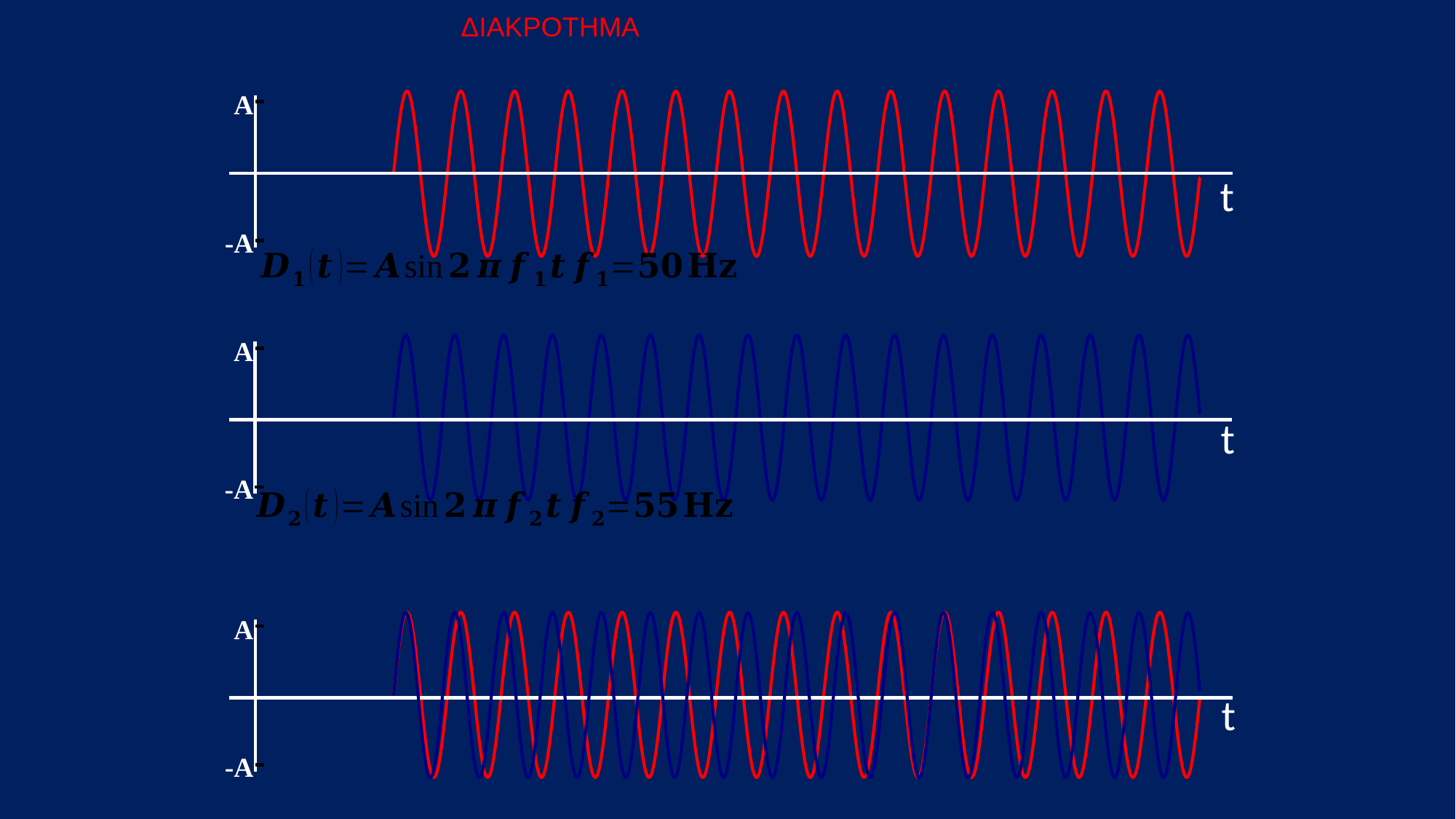
What kind of chart is the top chart on the slide? line chart How many waveforms are plotted in the bottom chart? 2 What colour is the waveform in the middle chart? blue Is the amplitude of the red wave in the top chart greater or less than A? equal to A How many charts are shown on the slide? 3 In the top chart, what is the frequency f1 of the signal D1(t)? 50 Hz Which signal has the higher frequency, D1(t) in the top chart or D2(t) in the middle chart? D2(t) In the middle chart, what is the frequency f2 of the signal D2(t)? 55 Hz What is the difference between the frequencies f2 and f1 given for the middle and top charts? 5 Hz What is the title written at the top of the slide? ΔΙΑΚΡΟΤΗΜΑ What is the label on the horizontal axis of the top chart? t What are the two tick labels on the vertical axis of the middle chart? A and -A